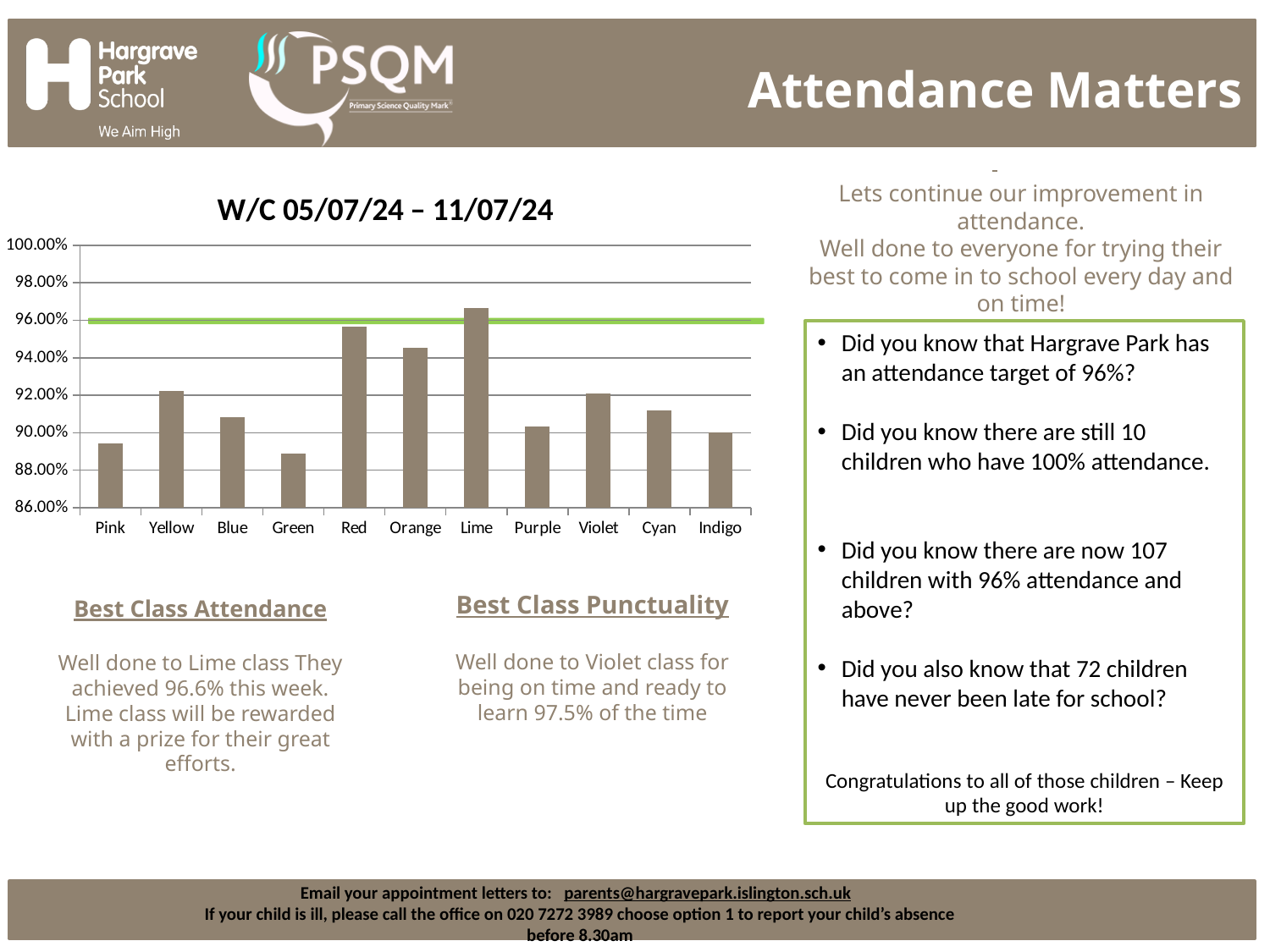
Which class has the higher bar, Red or Orange? Red Which class has the lowest attendance bar in the chart? Green Is the value for Orange greater or less than 94.00%? greater How many classes are shown on the x axis of the chart? 11 What is the title of the chart? W/C 05/07/24 – 11/07/24 Is the value for Cyan greater or less than 90.00%? greater Which class has the highest attendance bar in the chart? Lime What kind of chart is shown on the slide? bar chart Is the value for Green greater or less than 90.00%? less Which class has the higher bar, Yellow or Blue? Yellow